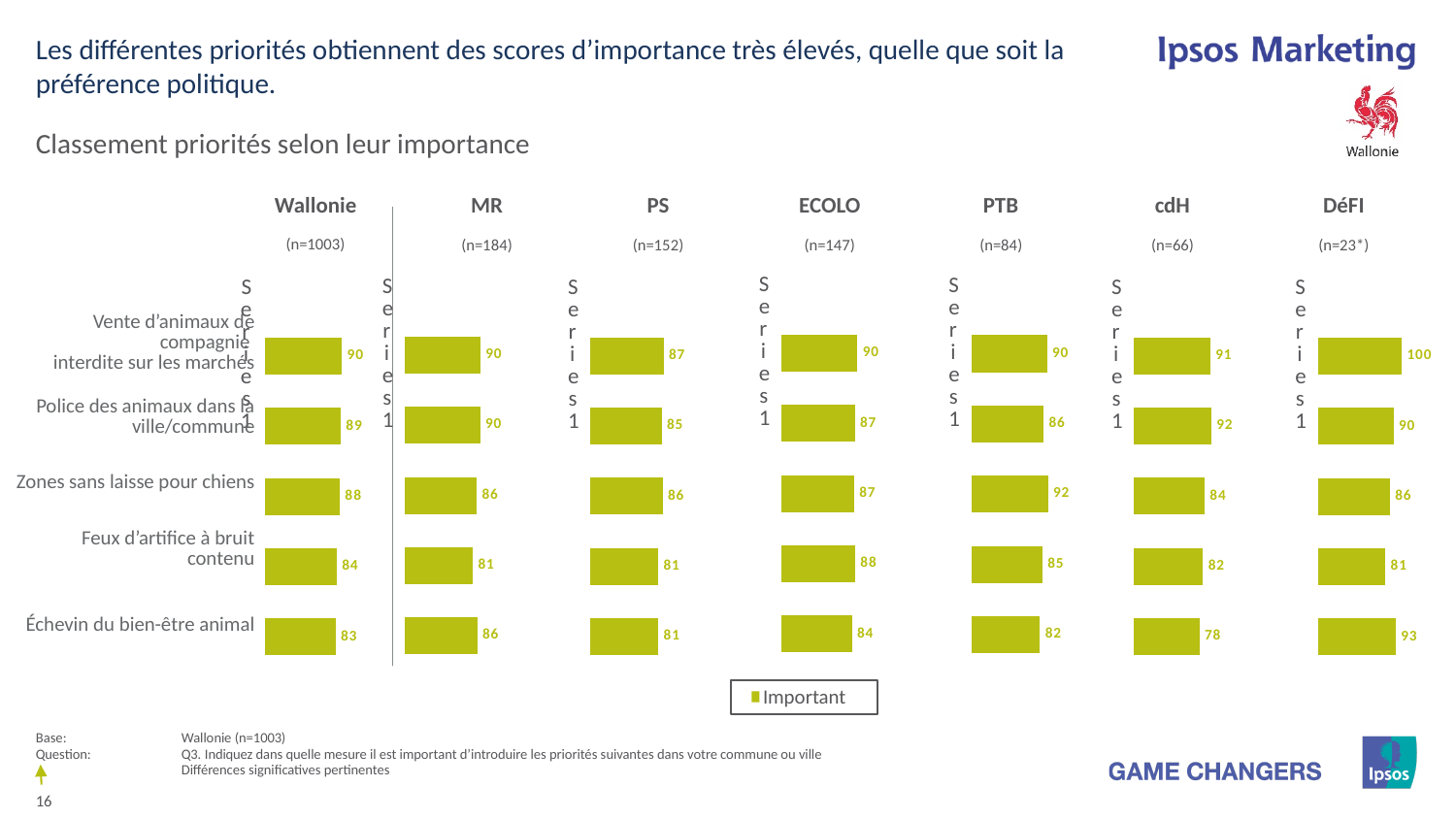
In the DéFI chart, what is the value for "Vente d'animaux de compagnie interdite sur les marchés"? 100 How many categories are shown in the Wallonie chart? 5 In the ECOLO chart, what is the difference between the values for "Vente d'animaux de compagnie interdite sur les marchés" and "Échevin du bien-être animal"? 6 In the Wallonie chart, what is the value for "Zones sans laisse pour chiens"? 88 What is the legend entry shown below the charts? Important In the DéFI chart, what is the difference between the values for "Échevin du bien-être animal" and "Feux d'artifice à bruit contenu"? 12 In the PTB chart, which category has the highest value? Zones sans laisse pour chiens What type of chart is used for the Wallonie column? Bar chart In the PS chart, which is larger: the value for "Police des animaux dans la ville/commune" or the value for "Zones sans laisse pour chiens"? Zones sans laisse pour chiens In the MR chart, what is the value for "Feux d'artifice à bruit contenu"? 81 In the cdH chart, which category has the lowest value? Échevin du bien-être animal How many series does the legend list? 1